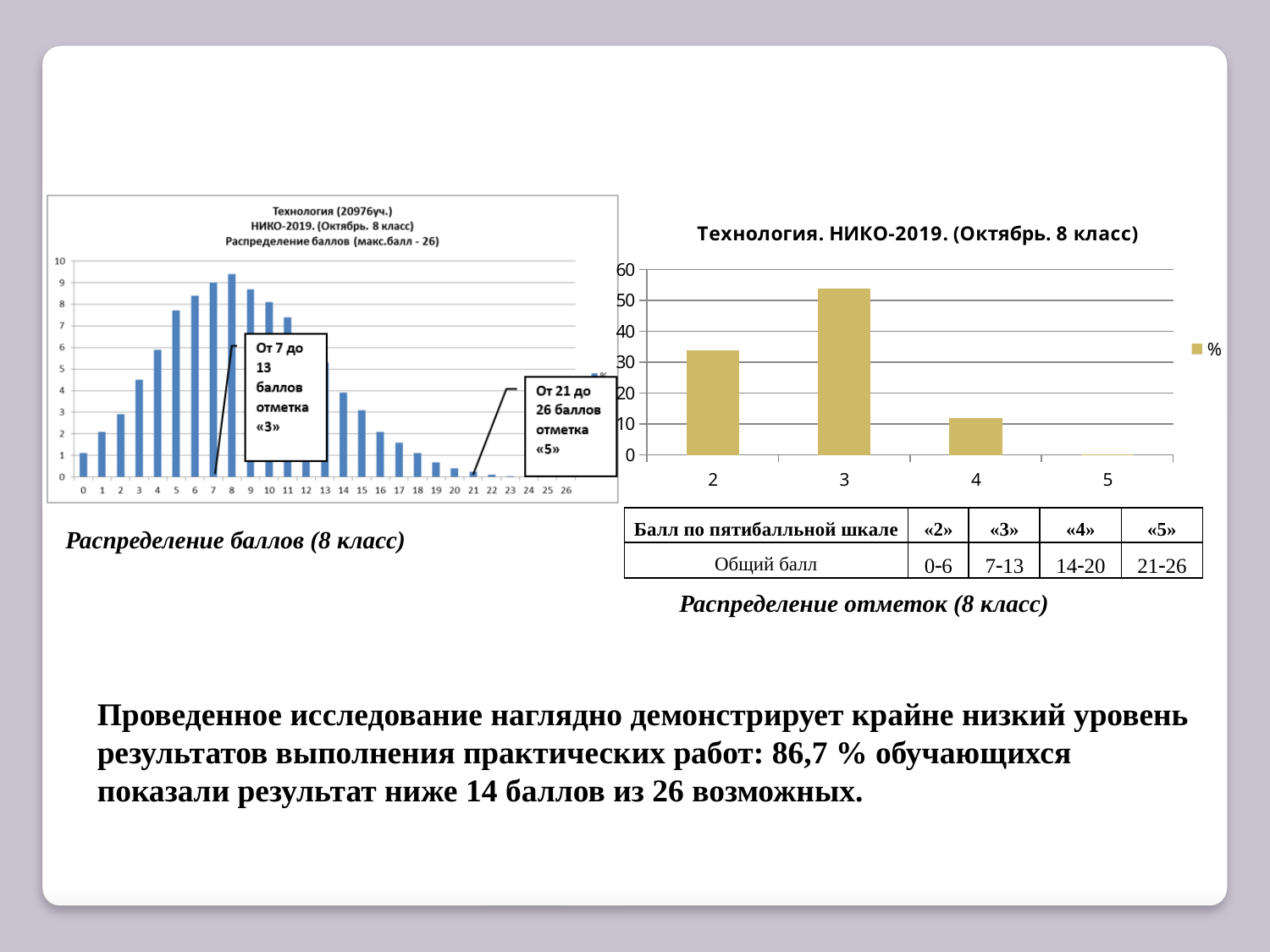
On the right chart titled «Технология. НИКО-2019. (Октябрь. 8 класс)», how many series does the legend list? 1 On the right chart titled «Технология. НИКО-2019. (Октябрь. 8 класс)», what is the legend entry? % On the right chart titled «Технология. НИКО-2019. (Октябрь. 8 класс)», how many grade categories are shown on the x axis? 4 On the right chart titled «Технология. НИКО-2019. (Октябрь. 8 класс)», which is larger, the value for grade 2 or the value for grade 4? grade 2 On the left chart showing the distribution of scores (Распределение баллов), how many score categories are shown on the x axis? 27 On the left chart showing the distribution of scores (Распределение баллов), which score has the highest bar? 8 On the left chart showing the distribution of scores (Распределение баллов), is the value for score 8 greater or less than 9? greater On the right chart titled «Технология. НИКО-2019. (Октябрь. 8 класс)», is the value for grade 3 greater or less than 50? greater What kind of chart is the left chart showing the distribution of scores (Распределение баллов)? bar chart On the right chart titled «Технология. НИКО-2019. (Октябрь. 8 класс)», is the value for grade 4 greater or less than 20? less On the right chart titled «Технология. НИКО-2019. (Октябрь. 8 класс)», which grade category has the highest bar? 3